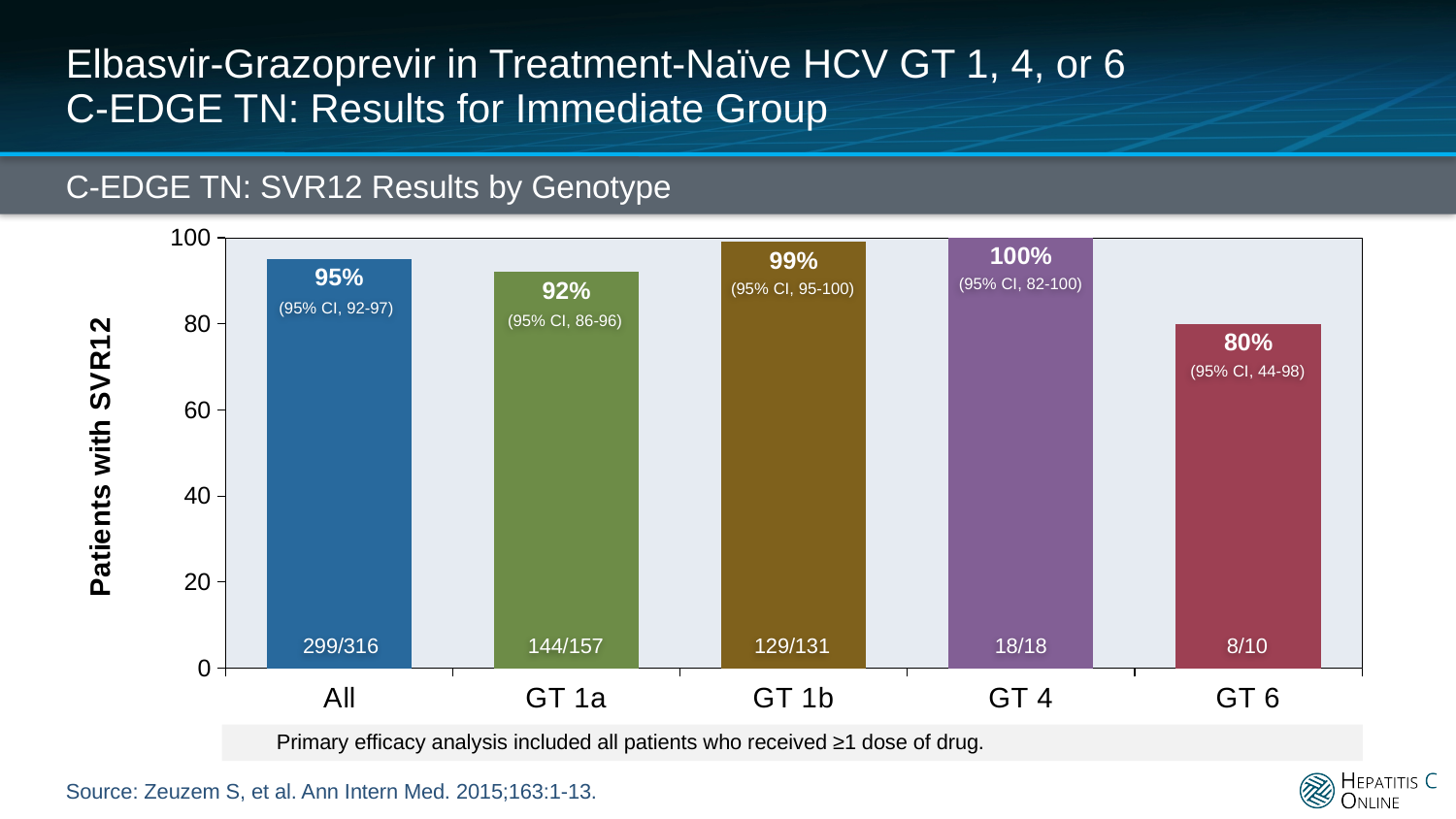
What is the SVR12 rate for the GT 6 group? 80% What is the title of the chart? C-EDGE TN: SVR12 Results by Genotype Which genotype group has the lowest SVR12 rate? GT 6 What is the 95% confidence interval shown for the GT 6 group? 95% CI, 44-98 Which has a higher SVR12 rate, GT 1a or GT 1b? GT 1b How many bars are shown in the chart? 5 What is the difference in SVR12 rate between GT 4 and GT 6? 20% What is the SVR12 rate for the All group? 95% What type of chart is shown on the slide? Bar chart What fraction of patients is shown for the GT 1b bar? 129/131 What is the SVR12 rate for the GT 1a group? 92% Which genotype group has the highest SVR12 rate? GT 4